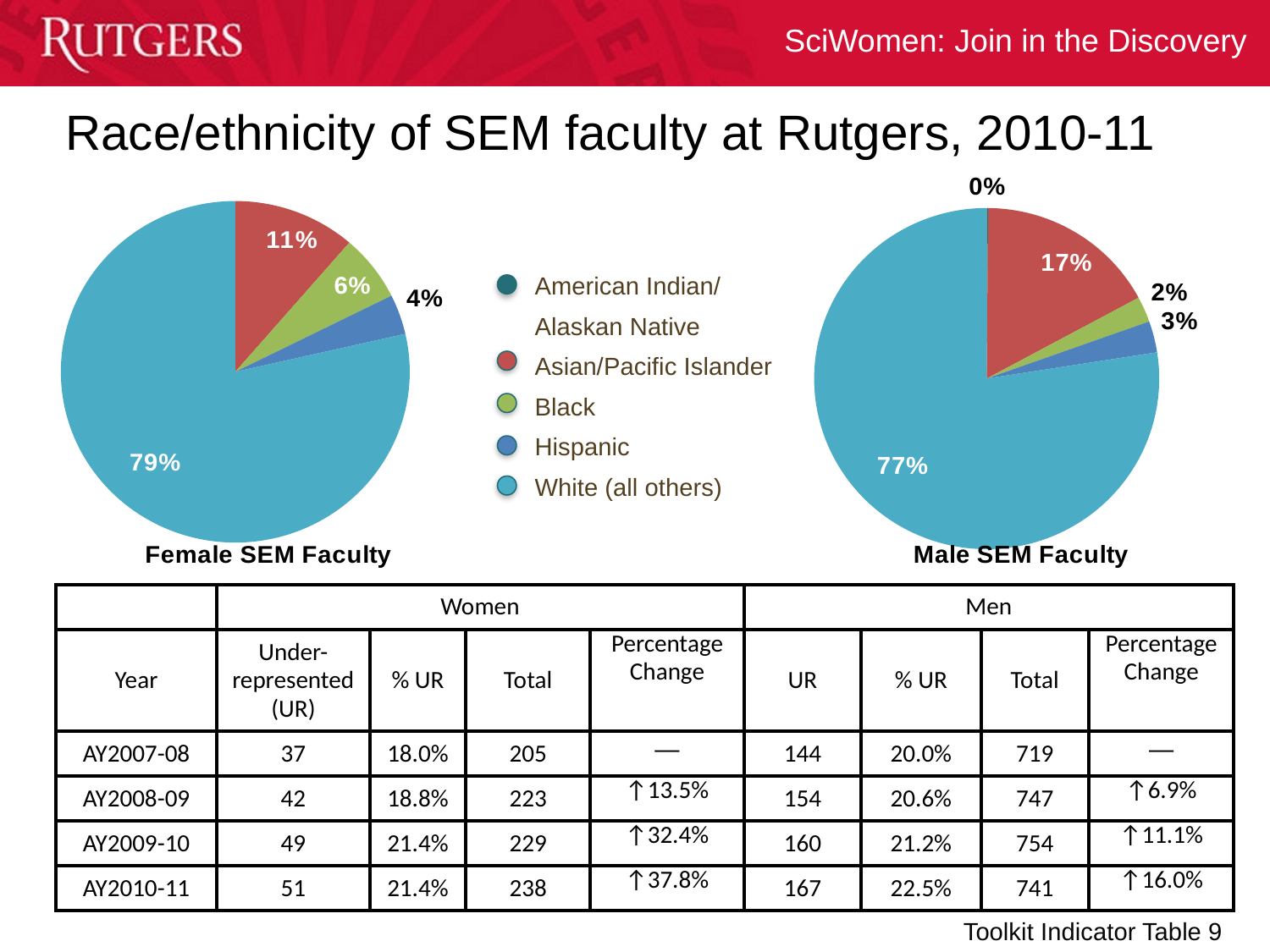
In the Female SEM Faculty pie chart, what share is Black? 6% In the Female SEM Faculty pie chart, what share is White (all others)? 79% Which chart has the larger White (all others) share, Female SEM Faculty or Male SEM Faculty? Female SEM Faculty In the Male SEM Faculty pie chart, what share is Hispanic? 3% In the Male SEM Faculty pie chart, which labeled category has the smallest share? American Indian/Alaskan Native What is the difference between the Asian/Pacific Islander share in the Male SEM Faculty chart and in the Female SEM Faculty chart? 6% What colour represents Hispanic in the pie charts? Blue How many categories does the legend list for the pie charts? 5 In the Female SEM Faculty pie chart, which category has the largest share? White (all others) What kind of charts are shown on the slide? Pie charts In the Male SEM Faculty pie chart, what share is American Indian/Alaskan Native? 0% In the Male SEM Faculty pie chart, what share is Asian/Pacific Islander? 17%